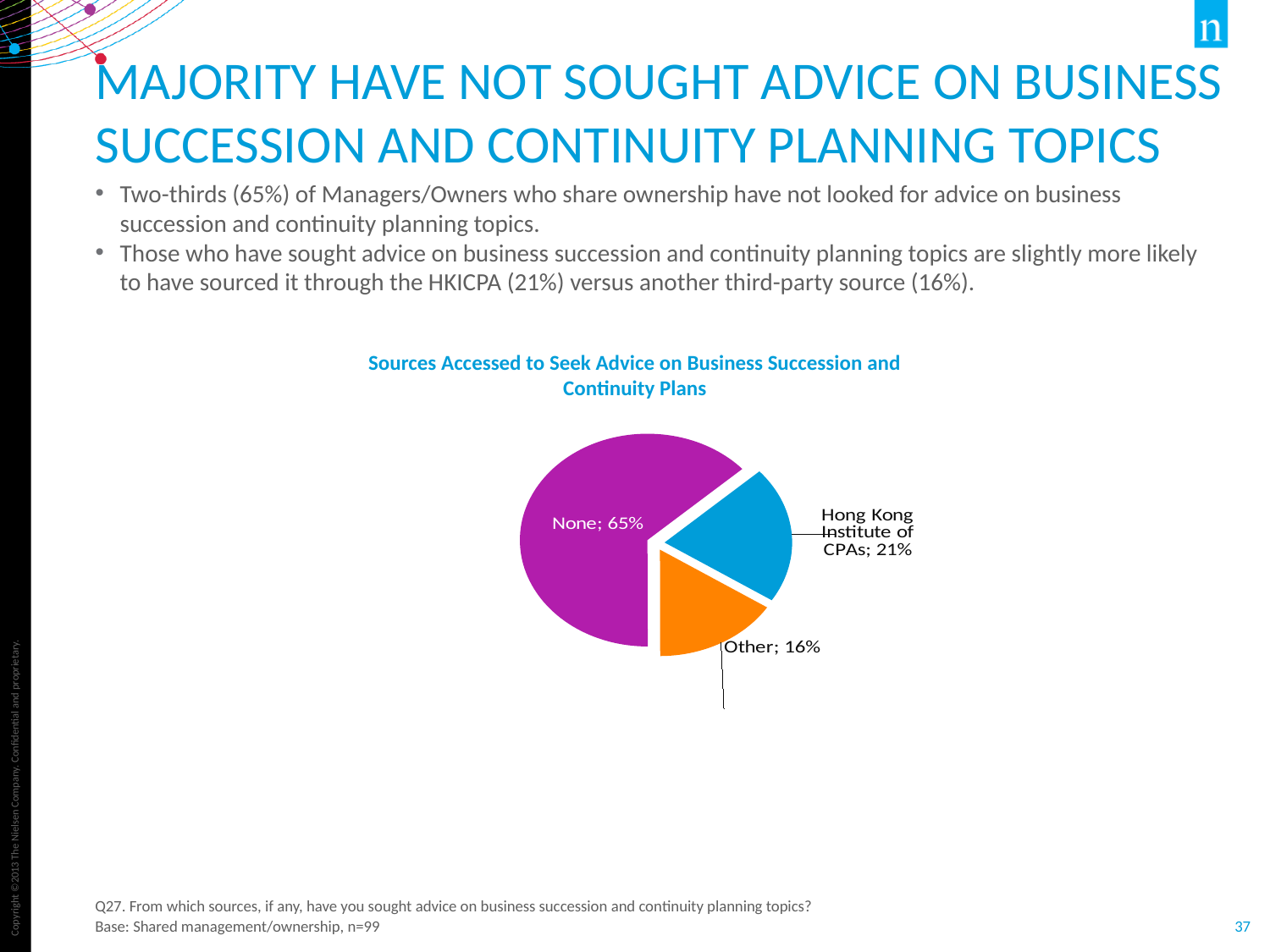
Which slice of the pie is the smallest? Other Which slice of the pie is the largest? None What colour is the None slice of the pie? Purple What share of the pie is labelled Hong Kong Institute of CPAs? 21% What share of the pie is labelled Other? 16% Which is larger, the Hong Kong Institute of CPAs slice or the Other slice? Hong Kong Institute of CPAs What is the title of the chart? Sources Accessed to Seek Advice on Business Succession and Continuity Plans What is the difference in percentage points between the None slice and the Hong Kong Institute of CPAs slice? 44 What kind of chart is shown on the slide? Pie chart How many slices does the pie chart have? 3 What share of the pie is labelled None? 65% What is the difference in percentage points between the Hong Kong Institute of CPAs slice and the Other slice? 5